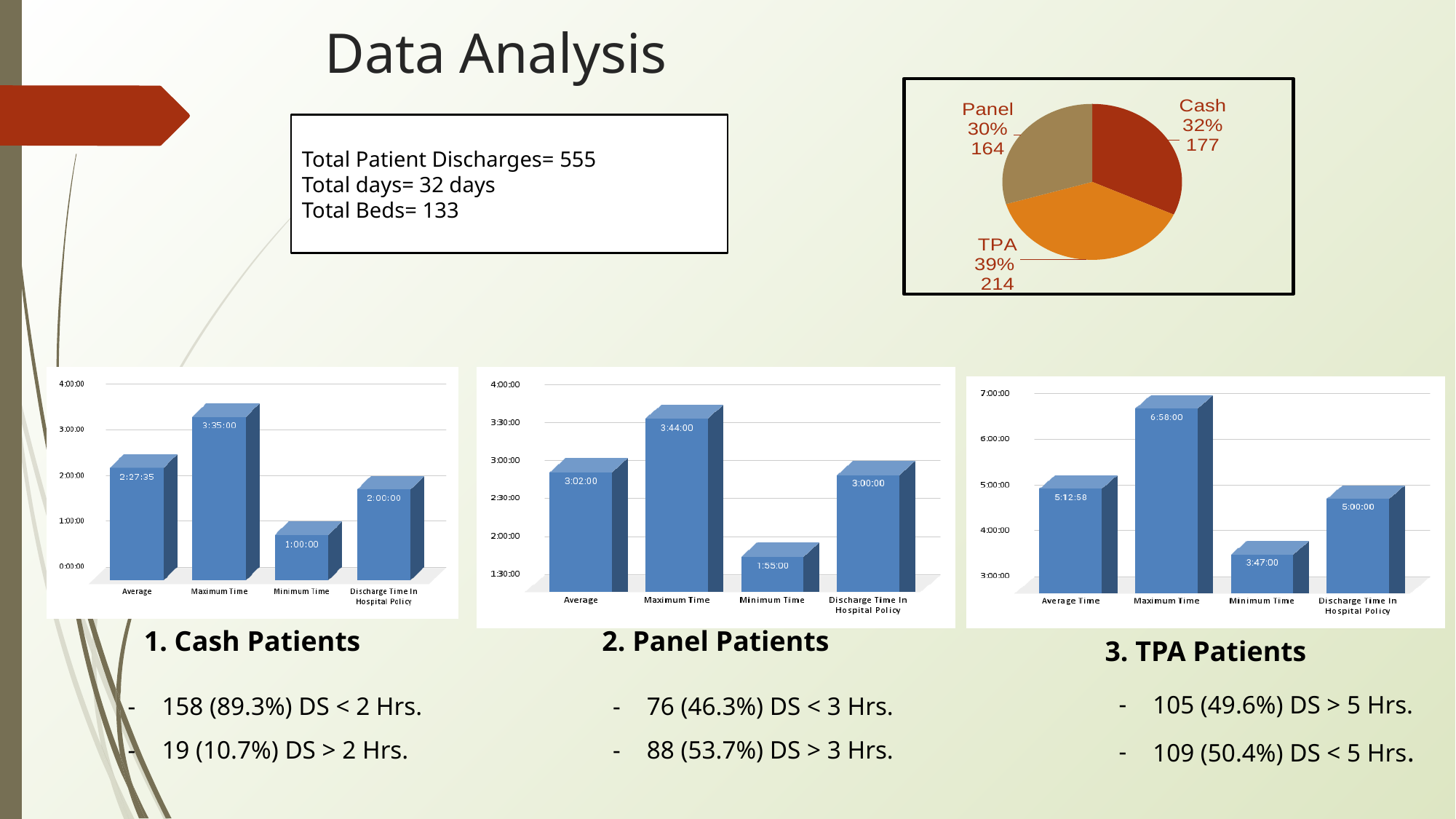
In the TPA Patients bar chart (bottom right), what is the value for Minimum Time? 3:47:00 What type of chart is used for the Cash Patients chart at the bottom left? Bar chart In the Cash Patients bar chart (bottom left), which category has the lowest value? Minimum Time In the pie chart at the top right, how many slices are there? 3 In the pie chart at the top right, what value is shown for the TPA slice? 214 In the pie chart at the top right, which category has the largest slice? TPA In the pie chart at the top right, which category has the smallest slice? Panel In the Panel Patients bar chart (bottom middle), what is the value for Average? 3:02:00 In the TPA Patients bar chart (bottom right), which category has the highest value? Maximum Time In the Panel Patients bar chart (bottom middle), which is larger: Average or Discharge Time In Hospital Policy? Average In the Cash Patients bar chart (bottom left), what is the value for Maximum Time? 3:35:00 In the pie chart at the top right, what percentage share does the Cash slice have? 32%